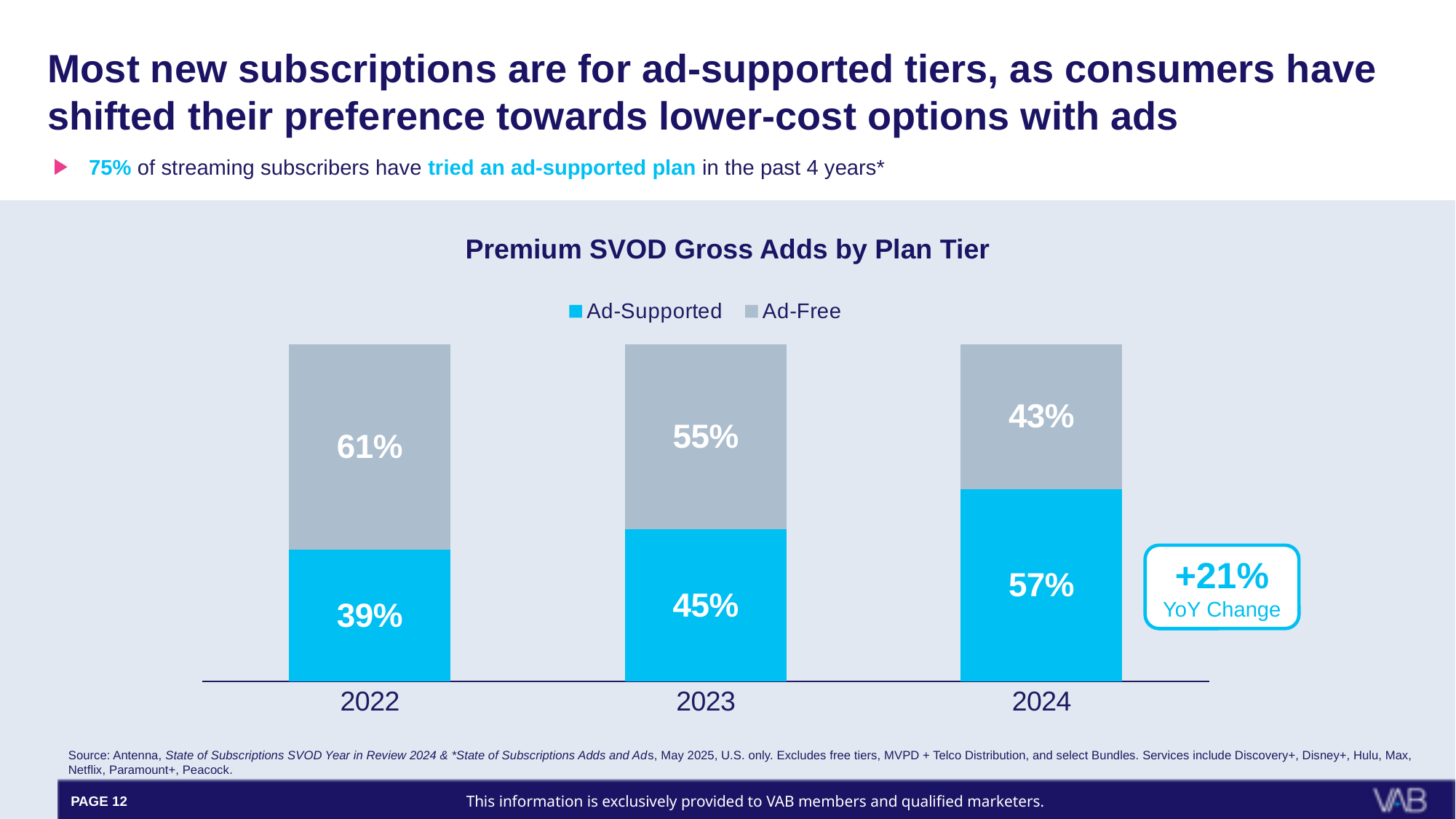
What kind of chart is used to show Premium SVOD Gross Adds by Plan Tier? Stacked bar chart In 2023, which is larger: the Ad-Supported share or the Ad-Free share? Ad-Free Does the Ad-Supported share rise or fall from 2022 to 2024? Rise What is the Ad-Free share of Premium SVOD gross adds in 2024? 43% How many years are shown on the x axis of the chart? 3 What is the difference between the Ad-Free and Ad-Supported shares in 2022? 22 percentage points What is the Ad-Free share of Premium SVOD gross adds in 2023? 55% What is the Ad-Supported share of Premium SVOD gross adds in 2022? 39% In which year is the Ad-Free share lowest? 2024 How many series does the chart legend list? 2 What is the Ad-Supported share of Premium SVOD gross adds in 2024? 57% In which year is the Ad-Supported share highest? 2024